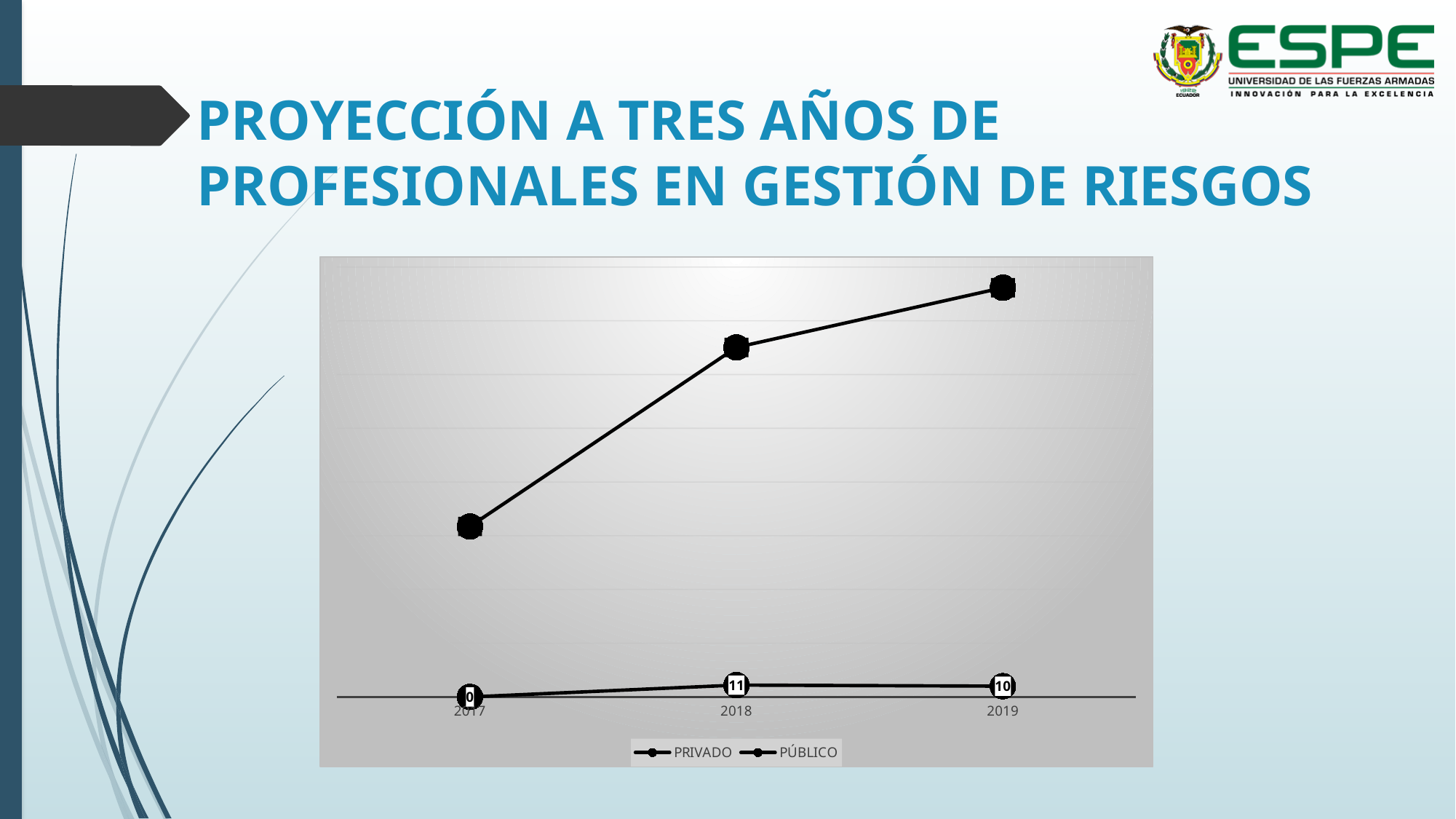
On the lower line of the chart, which year has the highest value? 2018 What is the data label shown for 2017 on the lower line of the chart? 0 What is the data label shown for 2018 on the lower line of the chart? 11 What are the two series names listed in the chart legend? PRIVADO and PÚBLICO Does the upper line of the chart rise or fall from 2017 to 2019? rise How many years are plotted along the x axis of the chart? 3 What kind of chart is shown on the slide? line chart How many series does the chart legend list? 2 On the lower line of the chart, which year has the lowest value? 2017 On the lower line of the chart, what is the difference between the 2018 value and the 2019 value? 1 What is the data label shown for 2019 on the lower line of the chart? 10 On the lower line of the chart, which year has the higher value, 2018 or 2019? 2018